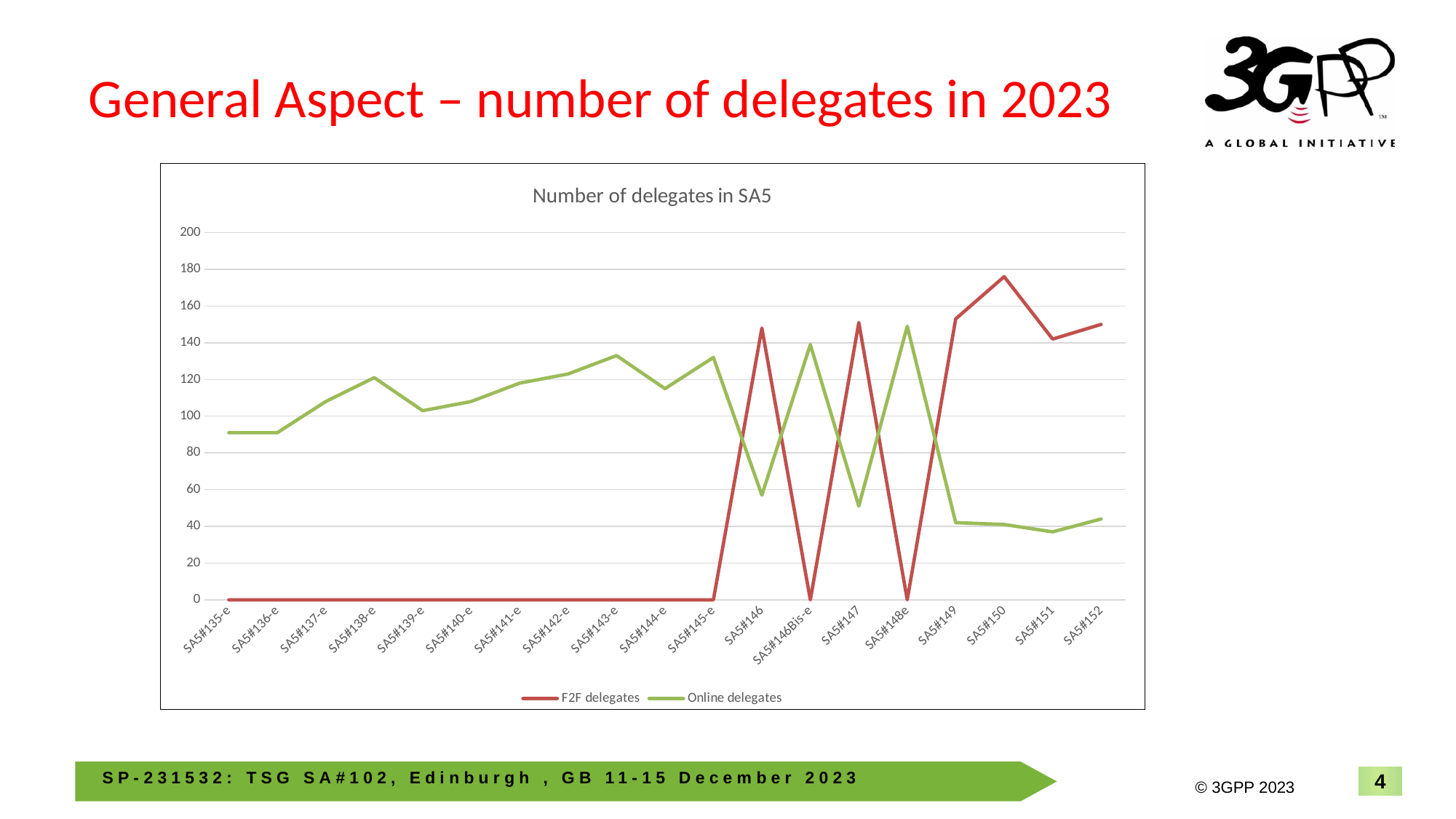
At which meeting is the number of Online delegates highest? SA5#148e Is the value for F2F delegates at SA5#150 greater or less than 160? greater Do the Online delegates values rise or fall from SA5#135-e to SA5#138-e? rise How many series does the legend list? 2 At SA5#146, which series has the larger value, F2F delegates or Online delegates? F2F delegates Is the value for Online delegates at SA5#147 greater or less than 60? less What is the value for F2F delegates at SA5#140-e? 0 What is the value for F2F delegates at SA5#146Bis-e? 0 What is the title of the chart? Number of delegates in SA5 How many meetings (categories) are plotted along the x axis? 19 At which meeting is the number of F2F delegates highest? SA5#150 What kind of chart is shown on the slide? line chart